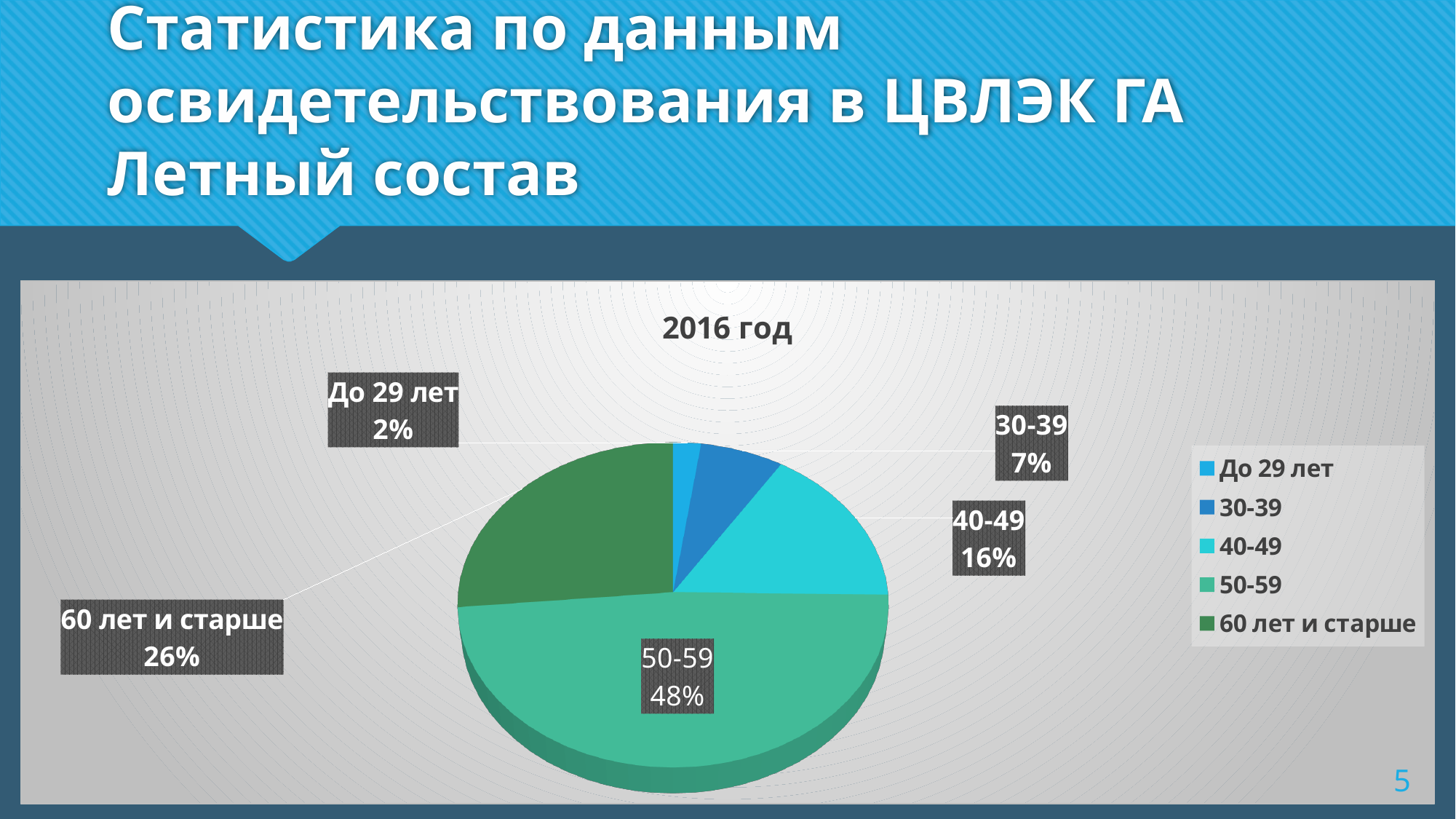
Which is larger, the share for 40-49 or the share for 30-39? 40-49 What is the value shown for the 30-39 age group? 7% What is the value shown for the 40-49 age group? 16% Which age group has the smallest share of the pie? До 29 лет What is the chart's title? 2016 год What kind of chart is shown on the slide? pie chart What share of the pie does the 60 лет и старше group have? 26% Which age group has the largest share of the pie? 50-59 How many age groups does the legend list? 5 What share of the pie does the 50-59 age group have? 48% What is the difference between the shares of the 50-59 and 60 лет и старше groups? 22% What is the value shown for the До 29 лет group? 2%